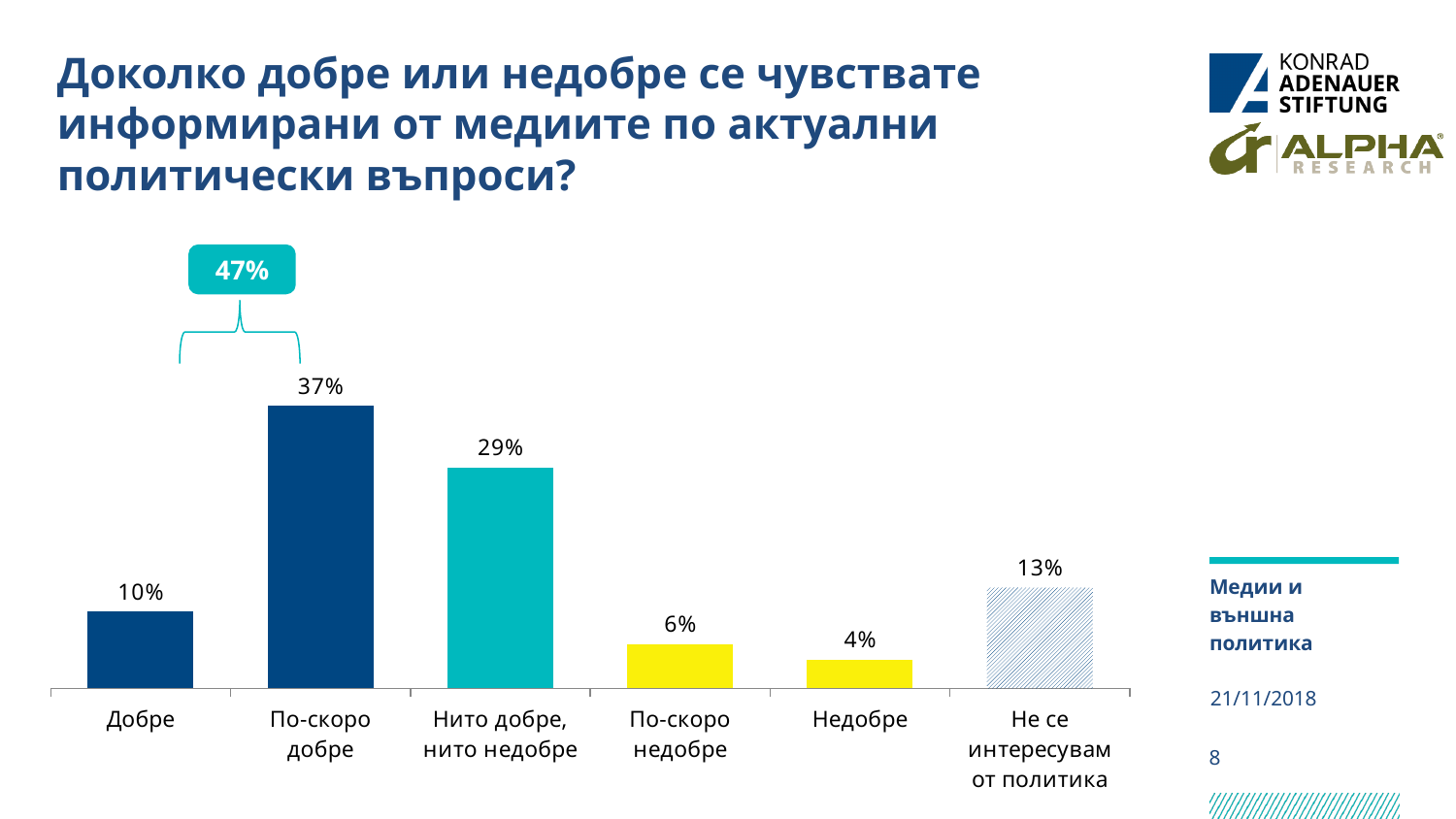
What is the value for "Нито добре, нито недобре"? 29% What is the value for "Не се интересувам от политика"? 13% What is the difference between the values for "По-скоро добре" and "Нито добре, нито недобре"? 8% What is the total of the values for "По-скоро недобре" and "Недобре"? 10% Which is larger, the value for "Добре" or the value for "Не се интересувам от политика"? Не се интересувам от политика Which category has the highest value? По-скоро добре What is the value for "Недобре"? 4% What is the value for "По-скоро добре"? 37% What combined value is shown in the callout above the first two bars? 47% How many categories are shown on the x axis? 6 Which category has the lowest value? Недобре What kind of chart is shown on the slide? Bar chart